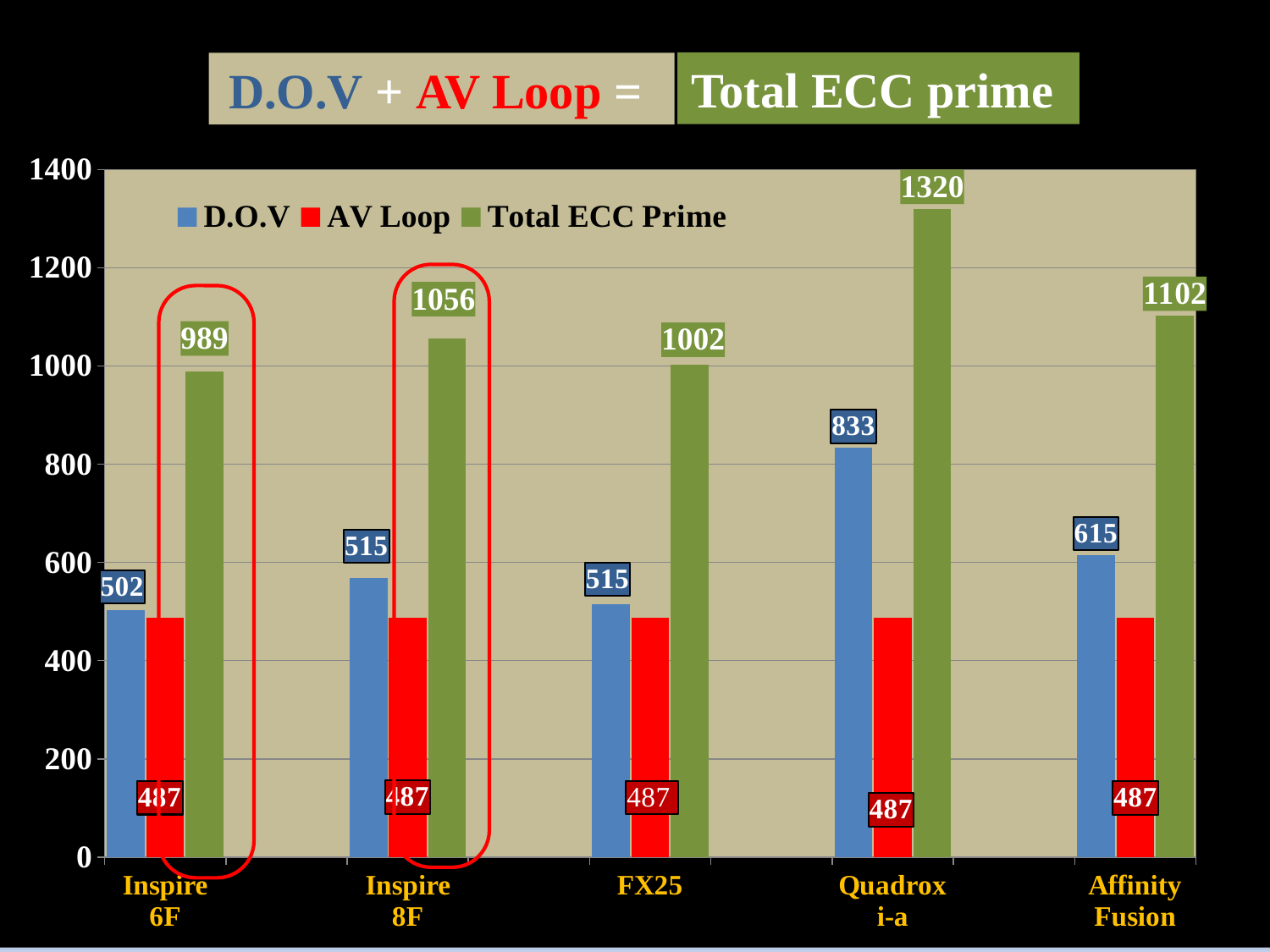
Which category has the lowest Total ECC Prime value? Inspire 6F What is the Total ECC Prime value for Quadrox i-a? 1320 Which is larger, the Total ECC Prime value for Inspire 8F or for FX25? Inspire 8F Which category has the highest Total ECC Prime value? Quadrox i-a How many categories are shown on the x axis? 5 How many series does the legend list? 3 What is the Total ECC Prime value for Inspire 6F? 989 What is the D.O.V value for Affinity Fusion? 615 What is the AV Loop value for FX25? 487 What kind of chart is shown on the slide? Bar chart What is the difference between the Total ECC Prime values for Quadrox i-a and Affinity Fusion? 218 Which category has the highest D.O.V value? Quadrox i-a